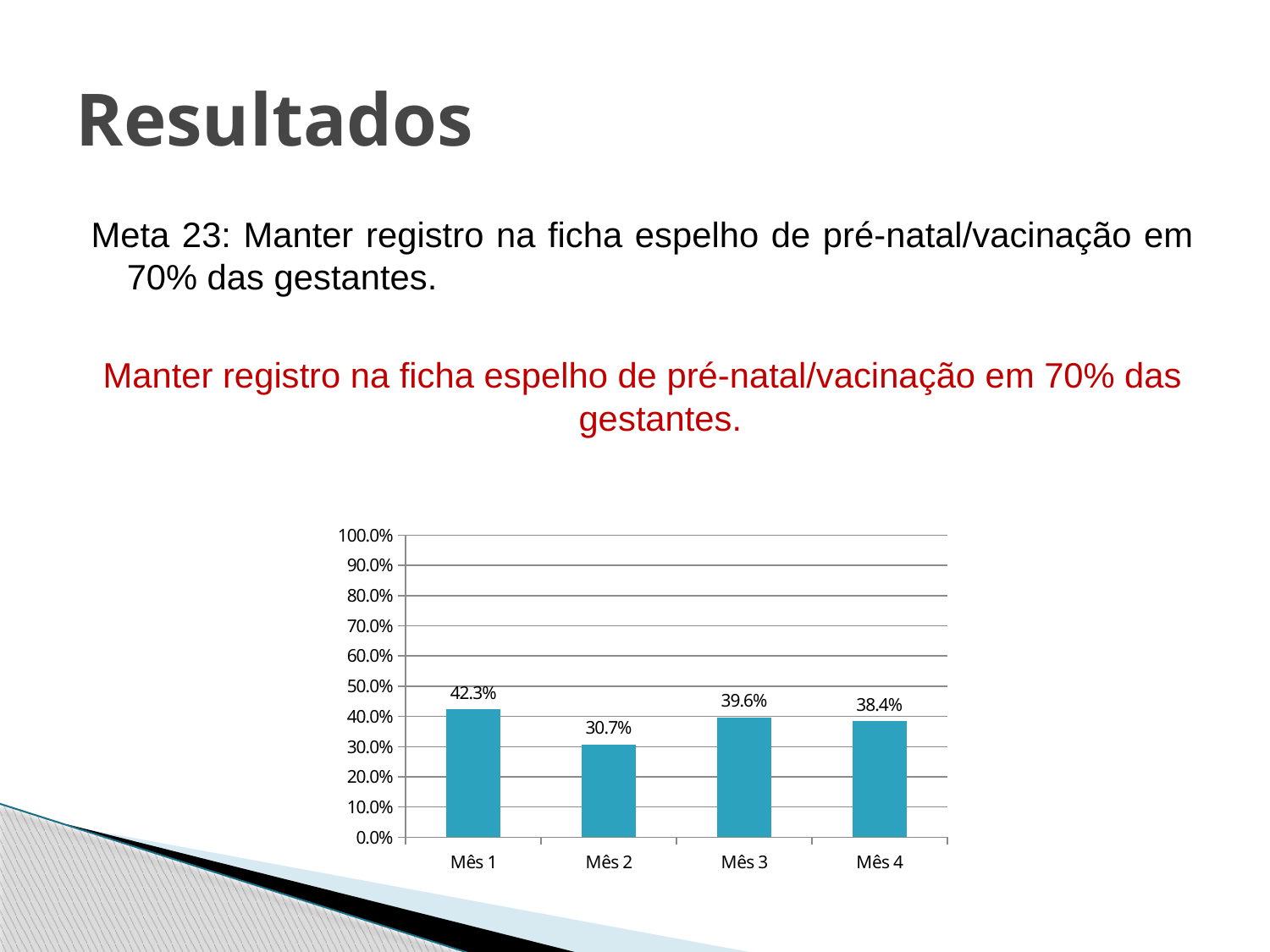
Which is larger, the value for Mês 3 or the value for Mês 4? Mês 3 What is the value for Mês 2? 30.7% Which month has the highest value? Mês 1 Which month has the lowest value? Mês 2 What is the value for Mês 3? 39.6% What is the difference between the values for Mês 1 and Mês 2? 11.6% What is the highest value shown on the y axis? 100.0% Is the value for Mês 2 greater or less than 40.0%? less What kind of chart is shown on the slide? bar chart What is the value for Mês 1? 42.3% How many months are shown on the x axis? 4 What is the value for Mês 4? 38.4%